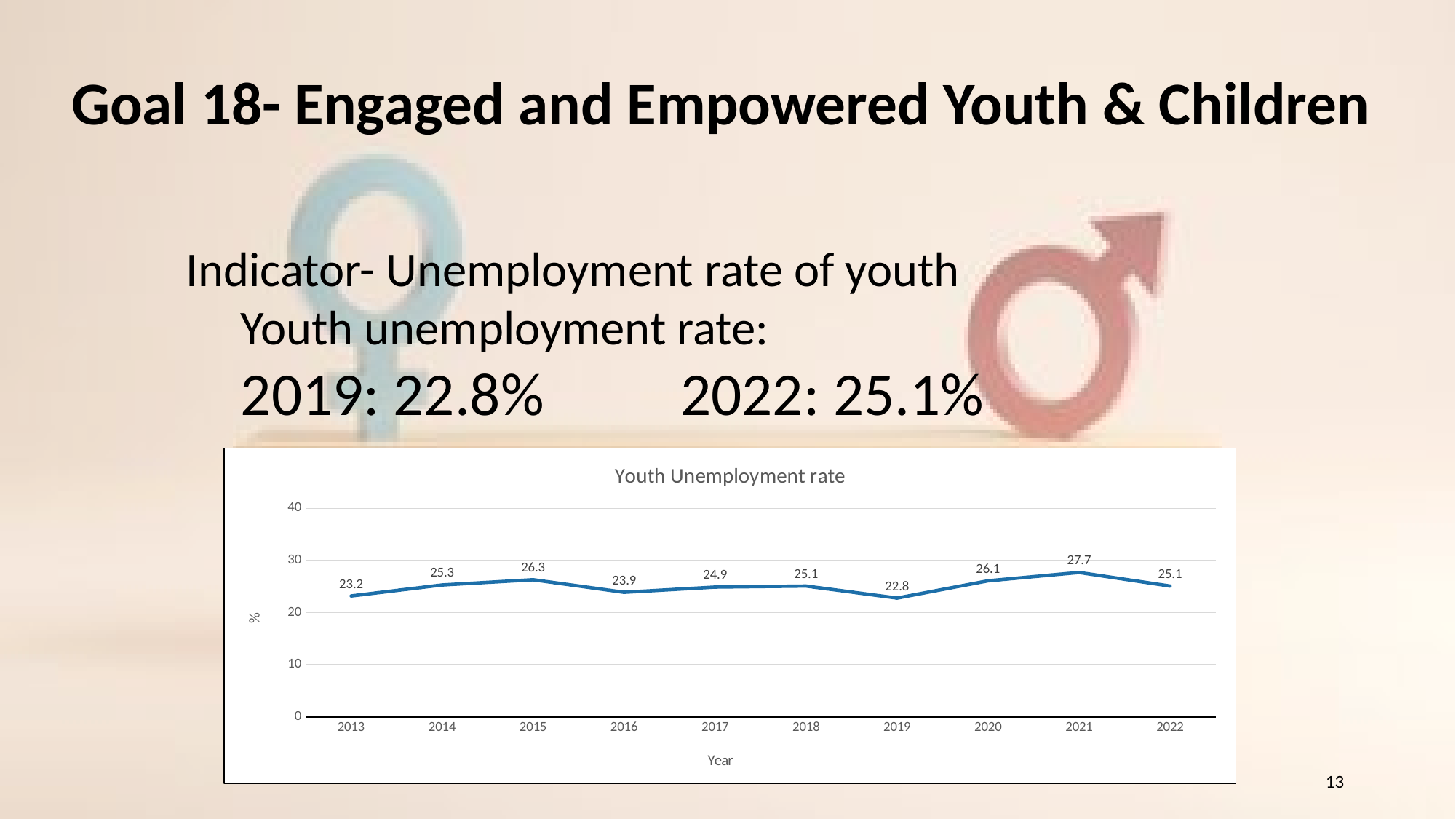
Is the youth unemployment rate for 2020 greater or less than 20? greater How many years are plotted on the chart? 10 What is the youth unemployment rate for 2021? 27.7 Which year has the highest youth unemployment rate? 2021 What is the youth unemployment rate for 2019? 22.8 Does the youth unemployment rate rise or fall from 2019 to 2021? rise Which year has a higher youth unemployment rate, 2015 or 2016? 2015 What kind of chart is shown on the slide? line chart What is the title of the chart? Youth Unemployment rate Which year has the lowest youth unemployment rate? 2019 What is the youth unemployment rate for 2013? 23.2 What is the difference between the youth unemployment rate in 2021 and in 2019? 4.9